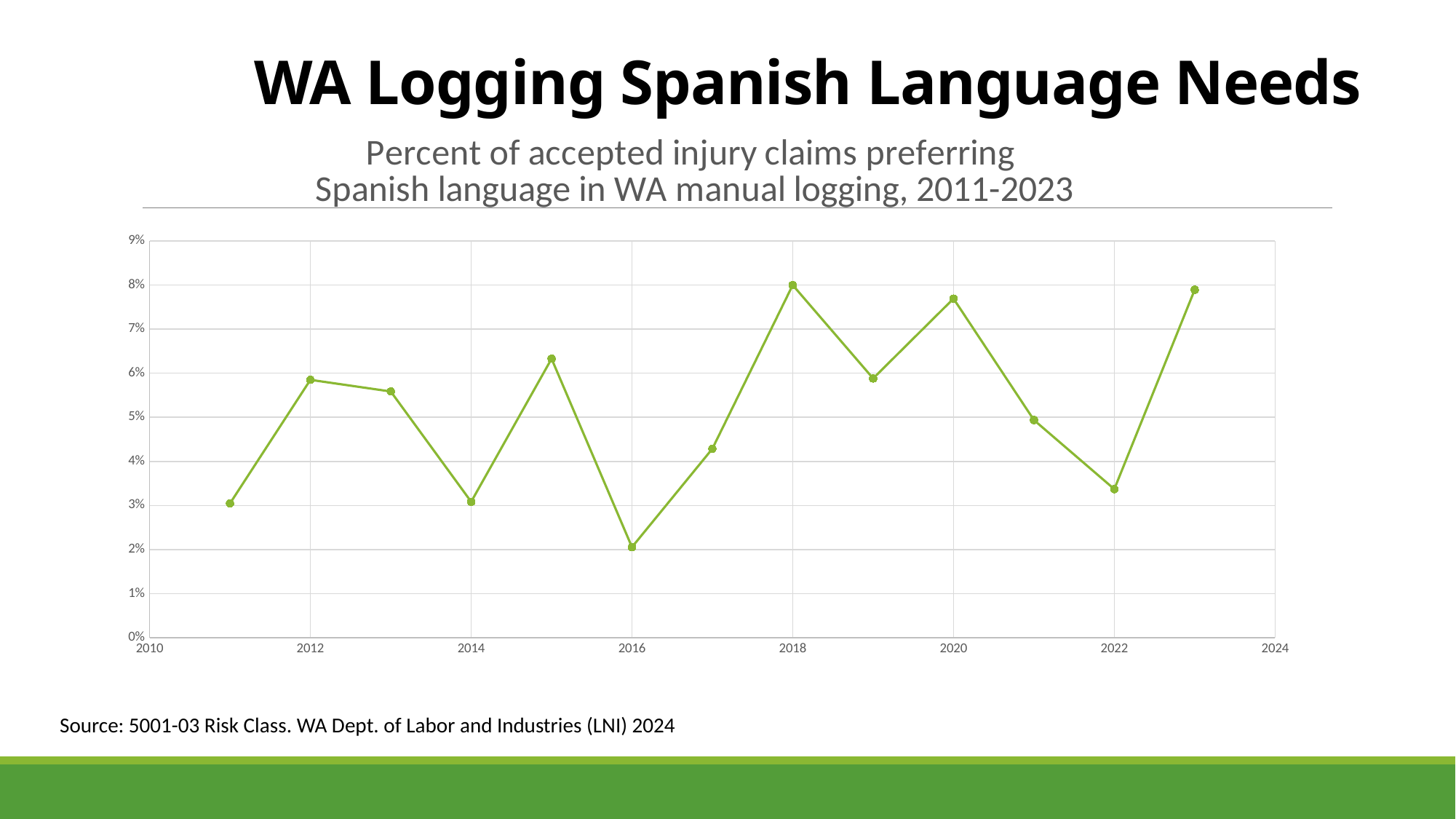
Is the value for 2011 greater or less than 2%? greater Is the value for 2018 greater or less than 7%? greater Is the value for 2012 greater or less than 5%? greater Do the values rise or fall from 2020 to 2022? fall How many data points are plotted on the line? 13 Which is larger, the value for 2018 or the value for 2016? 2018 What is the title of the chart? Percent of accepted injury claims preferring Spanish language in WA manual logging, 2011-2023 Which is larger, the value for 2020 or the value for 2021? 2020 What kind of chart is shown on the slide? line chart Which year has the lowest percent of accepted injury claims preferring Spanish language? 2016